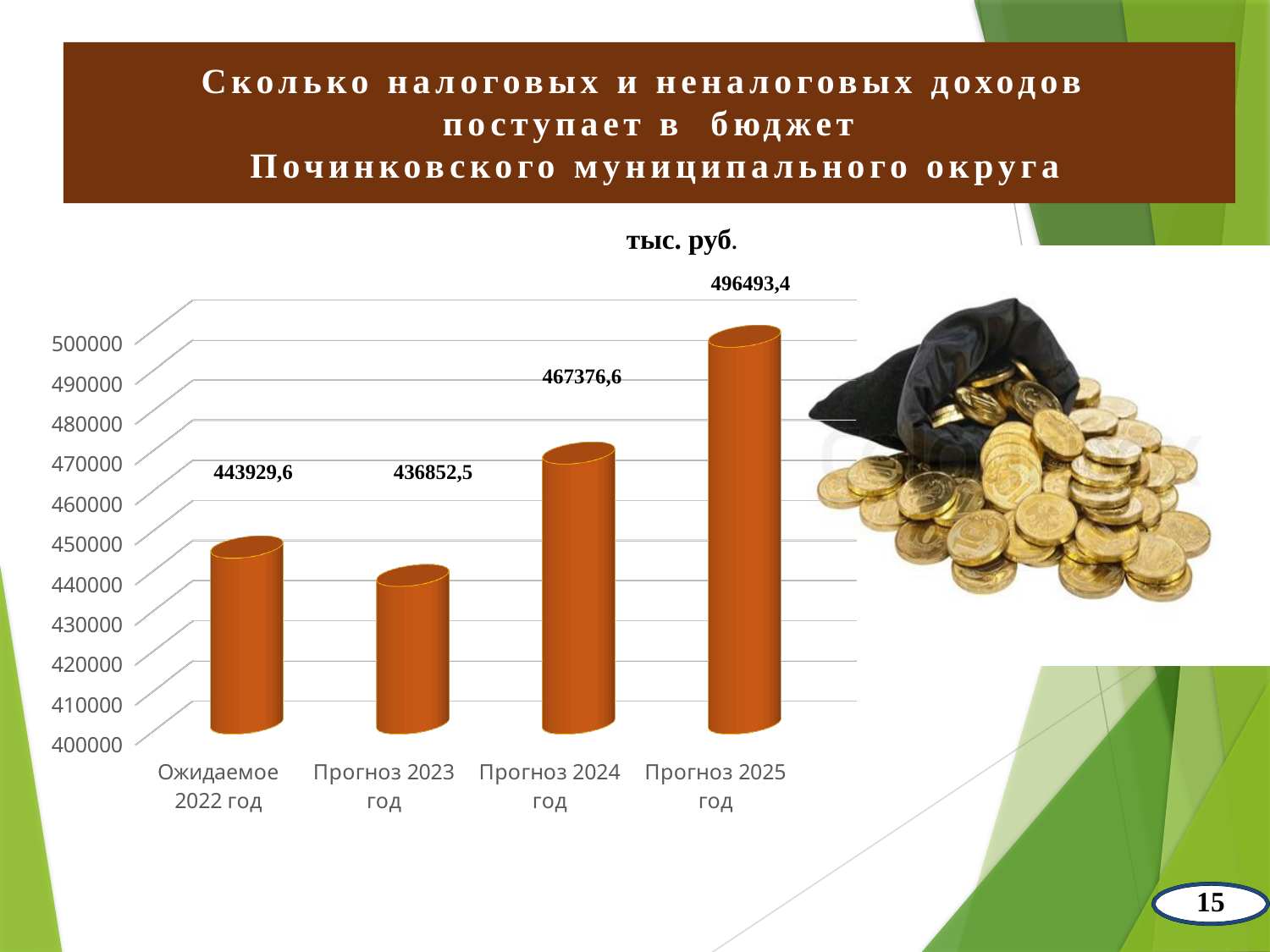
What is the value for Прогноз 2023 год? 436852,5 What kind of chart is shown on the slide? bar chart Which is larger, the value for Ожидаемое 2022 год or the value for Прогноз 2023 год? Ожидаемое 2022 год What is the value for Ожидаемое 2022 год? 443929,6 What is the difference between the values for Прогноз 2025 год and Прогноз 2023 год? 59640,9 What is the value for Прогноз 2025 год? 496493,4 How many categories are shown on the x axis? 4 What is the value for Прогноз 2024 год? 467376,6 Which category has the highest value? Прогноз 2025 год Which category has the lowest value? Прогноз 2023 год Is the value for Прогноз 2024 год greater or less than 460000? greater What is the difference between the values for Прогноз 2024 год and Ожидаемое 2022 год? 23447,0